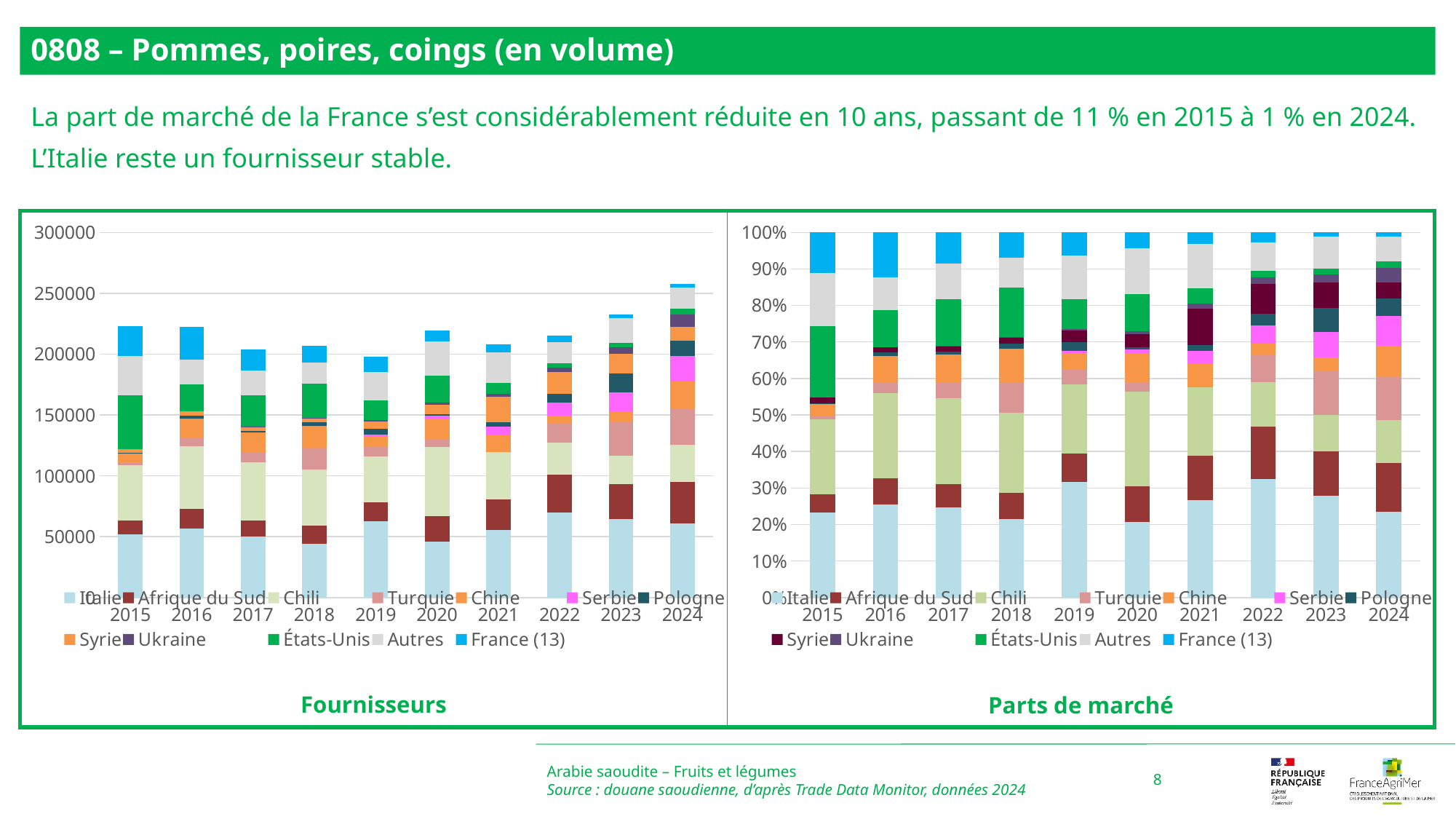
How many series does the legend of the 'Fournisseurs' chart list? 12 What kind of chart is the 'Fournisseurs' chart? Stacked bar chart In the 'Fournisseurs' chart, which year has the highest total volume? 2024 According to the slide, what was France's market share in 2024? 1 % In the 'Parts de marché' chart, is Italie's share larger in 2015 or in 2019? 2019 In the 'Fournisseurs' chart, does the total volume rise or fall from 2019 to 2024? rise In the 'Parts de marché' chart, is Chili's share larger in 2017 or in 2024? 2017 In the 'Fournisseurs' chart, is the total for 2024 greater or less than 250000? greater How many years are shown on the x axis of the 'Parts de marché' chart? 10 In the 'Fournisseurs' chart, is the total for 2015 greater or less than 200000? greater In the 'Fournisseurs' chart, is the total for 2017 greater or less than 250000? less According to the slide, what was France's market share in 2015? 11 %